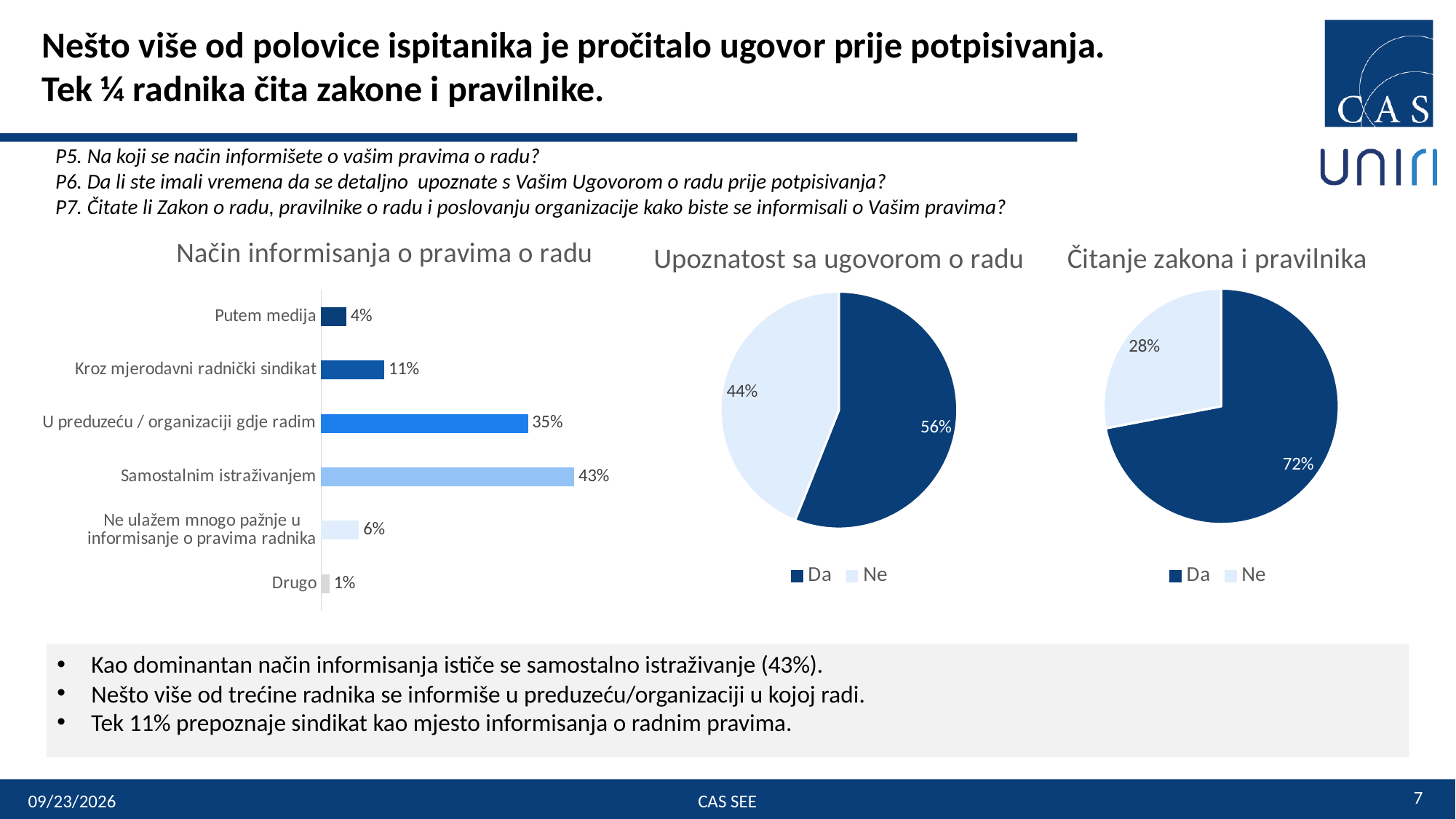
In the chart titled "Način informisanja o pravima o radu", what is the value for "Kroz mjerodavni radnički sindikat"? 11% In the pie chart titled "Čitanje zakona i pravilnika", what is the difference between "Da" and "Ne"? 44% In the pie chart titled "Čitanje zakona i pravilnika", what share is "Ne"? 28% What kind of chart is "Način informisanja o pravima o radu"? Bar chart In the chart titled "Način informisanja o pravima o radu", which category has the lowest value? Drugo How many entries does the legend of the pie chart titled "Upoznatost sa ugovorom o radu" list? 2 In the chart titled "Način informisanja o pravima o radu", what is the value for "Samostalnim istraživanjem"? 43% In the chart titled "Način informisanja o pravima o radu", which category has the highest value? Samostalnim istraživanjem How many categories are shown in the chart titled "Način informisanja o pravima o radu"? 6 In the chart titled "Način informisanja o pravima o radu", what is the difference between "Samostalnim istraživanjem" and "U preduzeću / organizaciji gdje radim"? 8% In the chart titled "Način informisanja o pravima o radu", which is larger: "Putem medija" or "Ne ulažem mnogo pažnje u informisanje o pravima radnika"? Ne ulažem mnogo pažnje u informisanje o pravima radnika In the pie chart titled "Upoznatost sa ugovorom o radu", what share is "Da"? 56%